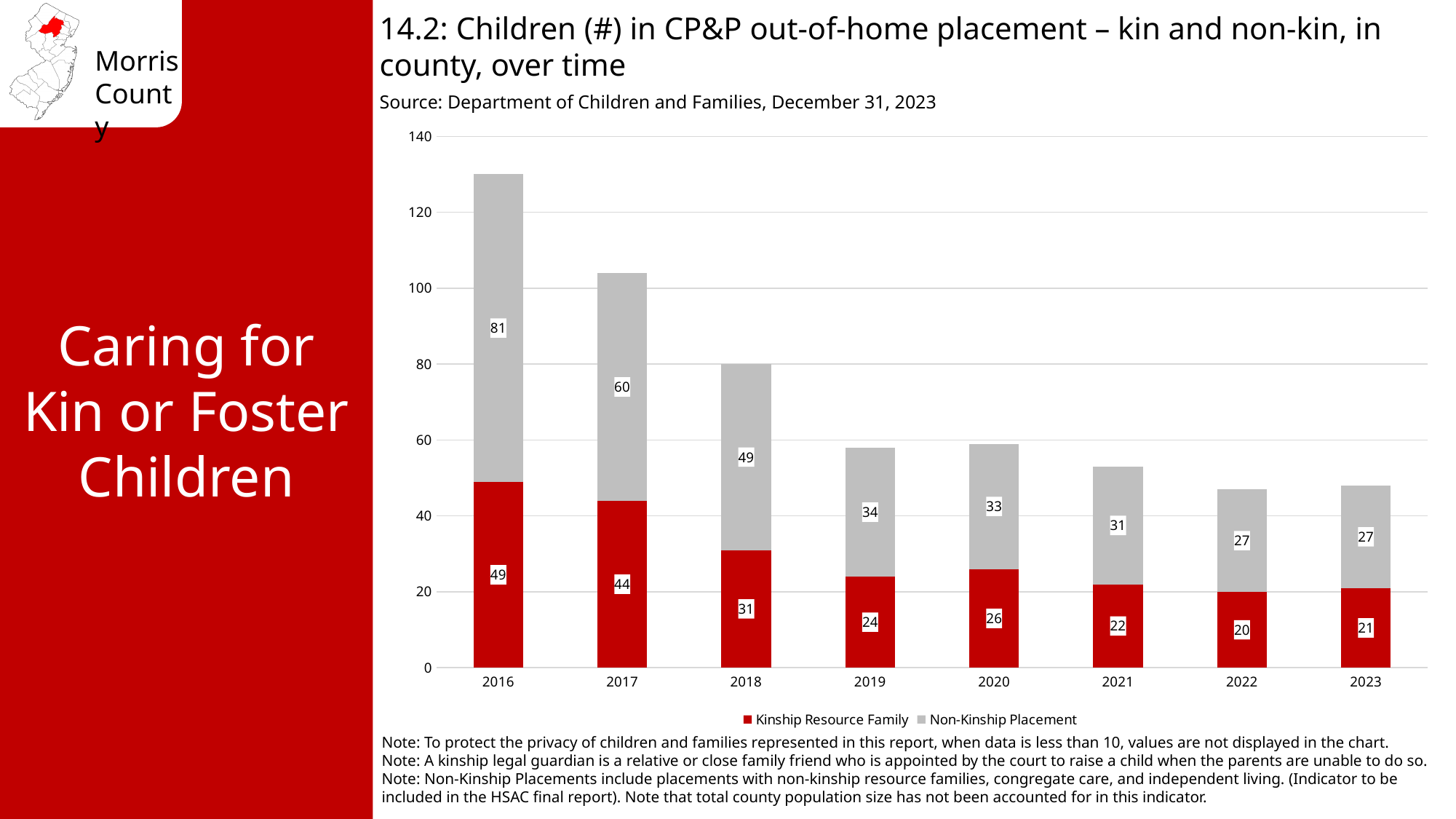
What is the Kinship Resource Family value for 2023? 21 What is the difference between the Non-Kinship Placement values for 2016 and 2017? 21 Is the total for the 2016 bar greater or less than 120? greater Which year has the highest Non-Kinship Placement value? 2016 What is the total of the stacked bar for 2021? 53 What is the Non-Kinship Placement value for 2019? 34 What is the Kinship Resource Family value for 2016? 49 How many series does the legend list? 2 Which is larger, the Kinship Resource Family value for 2018 or for 2020? 2018 Which year has the lowest Kinship Resource Family value? 2022 How many years are shown on the x axis? 8 Does the Non-Kinship Placement value generally rise or fall from 2016 to 2023? fall